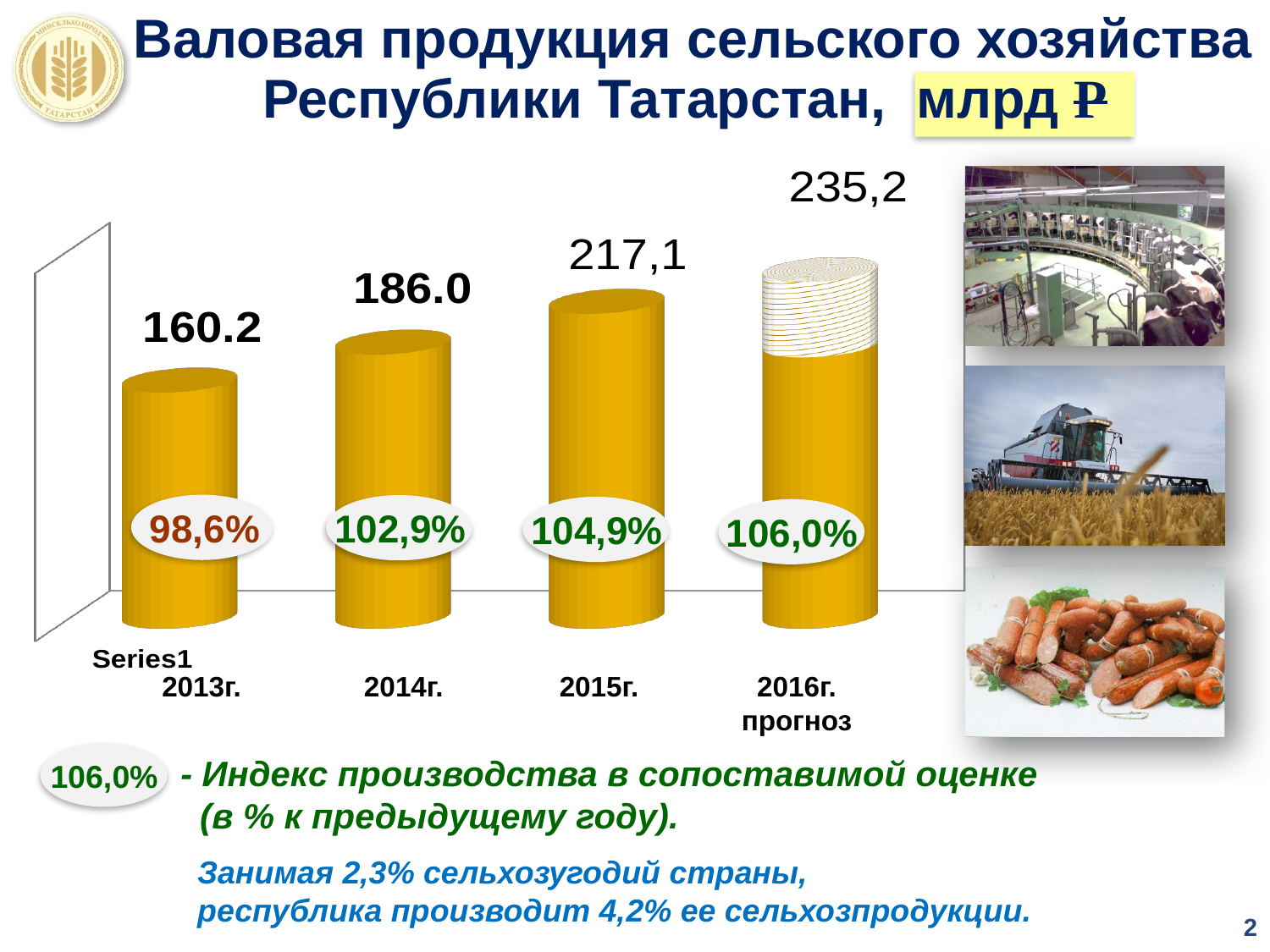
Which category has the highest value? 2016г. прогноз How many bars are shown in the chart? 4 What is the difference between the values for 2014г. and 2013г.? 25.8 What is the value for 2015г.? 217,1 Which is larger, the value for 2015г. or the value for 2014г.? 2015г. Do the values rise or fall from 2013г. to 2016г. прогноз? rise What is the difference between the values for 2016г. прогноз and 2015г.? 18,1 What is the value for 2013г.? 160.2 What kind of chart is shown on the slide? bar chart Which category has the lowest value? 2013г. What is the value for 2016г. прогноз? 235,2 What is the value for 2014г.? 186.0